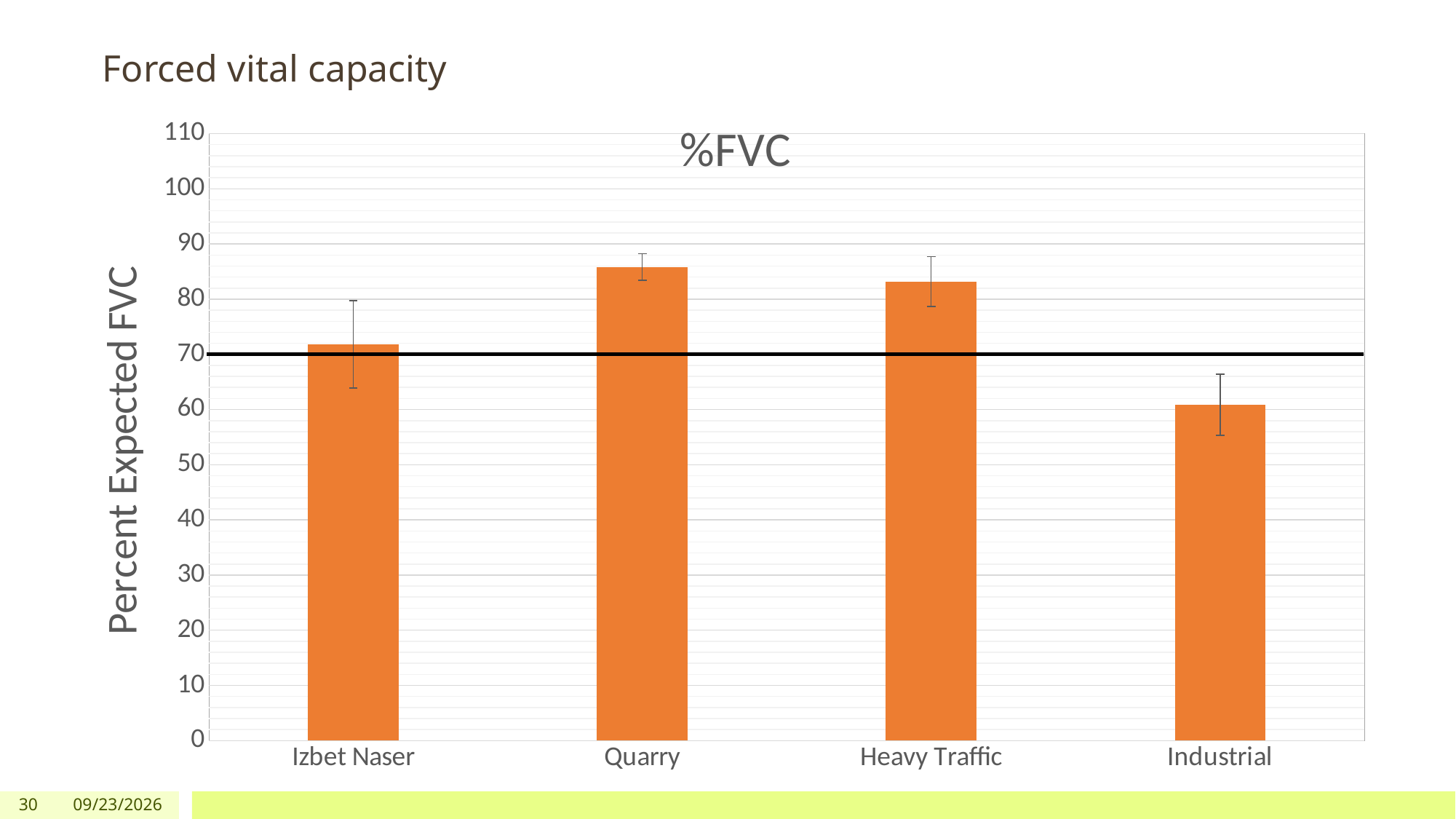
Which is larger, the value for Izbet Naser or the value for Industrial? Izbet Naser Is the value for Heavy Traffic greater or less than 80? greater Is the value for Izbet Naser greater or less than 80? less What is the label on the vertical axis of the chart? Percent Expected FVC How many categories are shown on the x axis of the chart? 4 What kind of chart is shown on the slide? bar chart Is the value for Quarry greater or less than 80? greater Which is larger, the value for Quarry or the value for Izbet Naser? Quarry What is the title of the chart? %FVC Which category has the highest percent expected FVC? Quarry Which category has the lowest percent expected FVC? Industrial